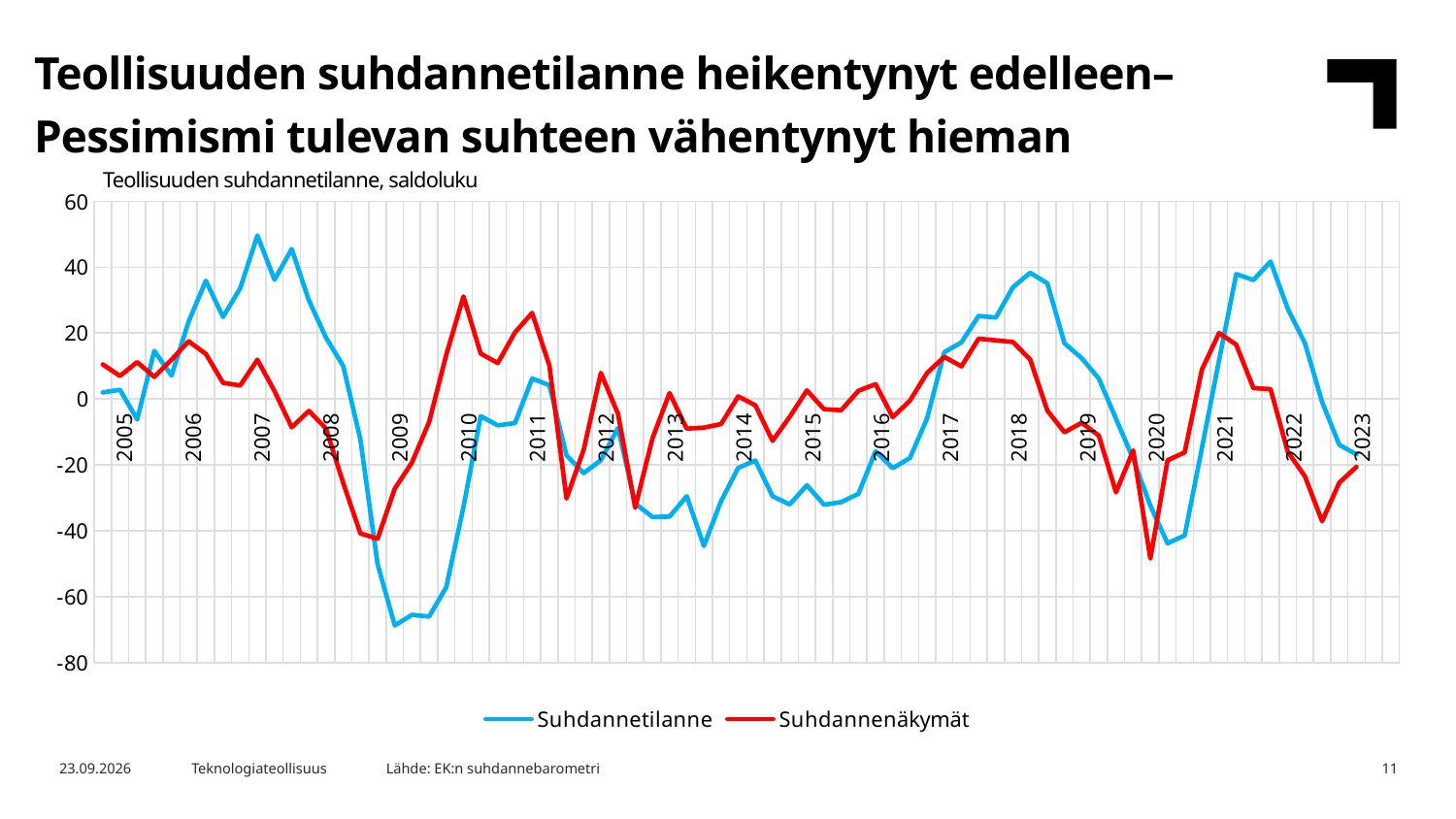
Which series reaches the lowest point anywhere on the chart? Suhdannetilanne How many series does the legend list? 2 Does the Suhdannetilanne line rise or fall from its 2021 peak to 2023? fall Which series reaches the highest point anywhere on the chart? Suhdannetilanne What is the title printed above the chart? Teollisuuden suhdannetilanne, saldoluku Is the peak of the Suhdannenäkymät line around 2010 greater or less than 20? greater What kind of chart is shown on the slide? line chart Is the lowest value of the Suhdannenäkymät line, reached around 2020, greater or less than -40? less How many year labels are shown on the x axis? 19 What are the two series named in the legend? Suhdannetilanne and Suhdannenäkymät Is the lowest value of the Suhdannetilanne line, reached around 2009, greater or less than -60? less